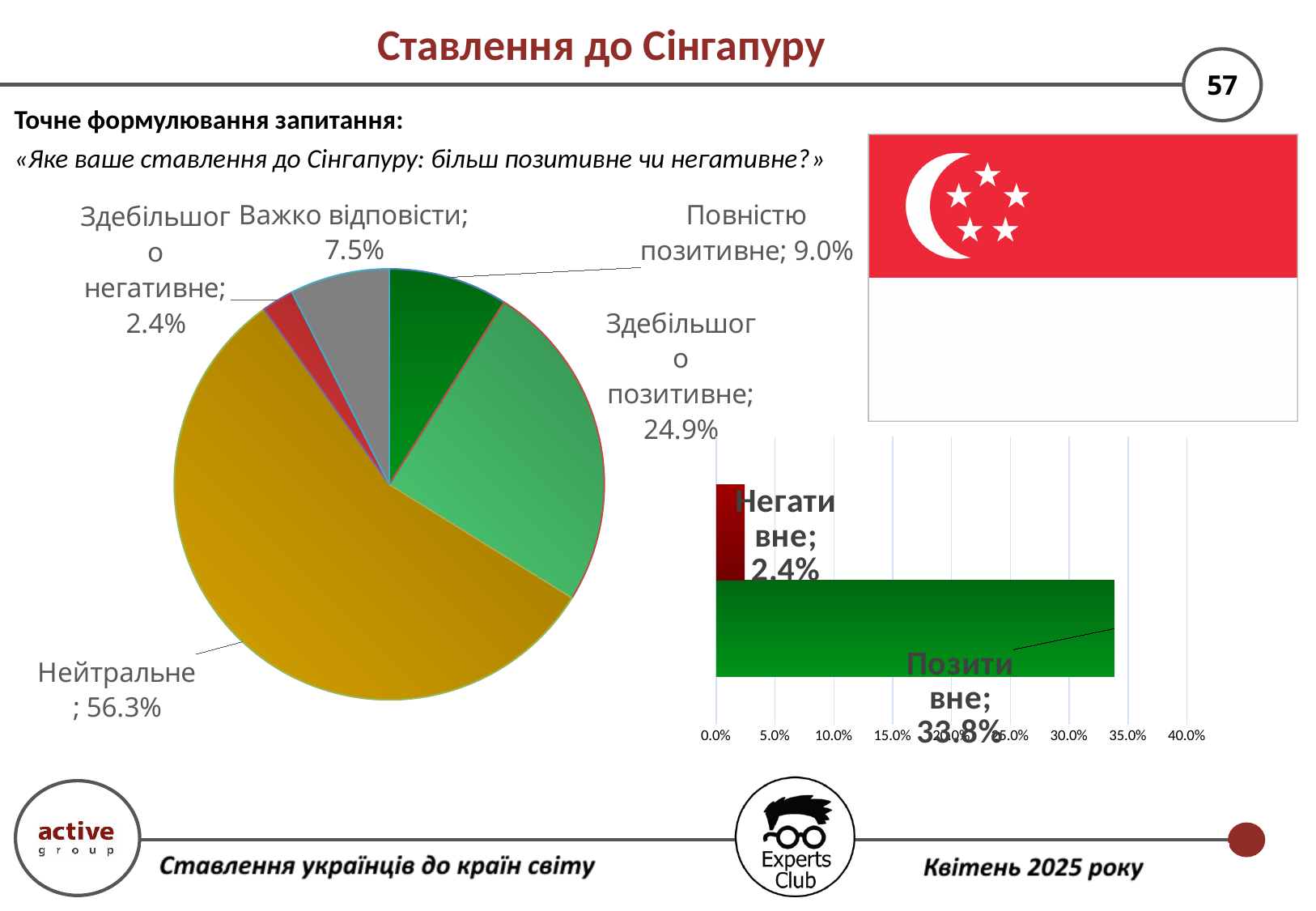
In the bar chart at the bottom right, which is larger, "Позитивне" or "Негативне"? Позитивне In the pie chart, which category has the largest slice? Нейтральне What type of chart is shown at the bottom right of the slide? Bar chart In the pie chart, how many slices are there? 5 In the pie chart, what share is labelled "Повністю позитивне"? 9.0% In the bar chart at the bottom right, what is the value for "Позитивне"? 33.8% In the bar chart at the bottom right, what is the value for "Негативне"? 2.4% In the pie chart, what share is labelled "Здебільшого позитивне"? 24.9% In the pie chart, what share is labelled "Важко відповісти"? 7.5% In the pie chart, which category has the smallest slice? Здебільшого негативне In the pie chart, what share is labelled "Нейтральне"? 56.3% In the pie chart, what is the difference between the "Здебільшого позитивне" and "Повністю позитивне" shares? 15.9%